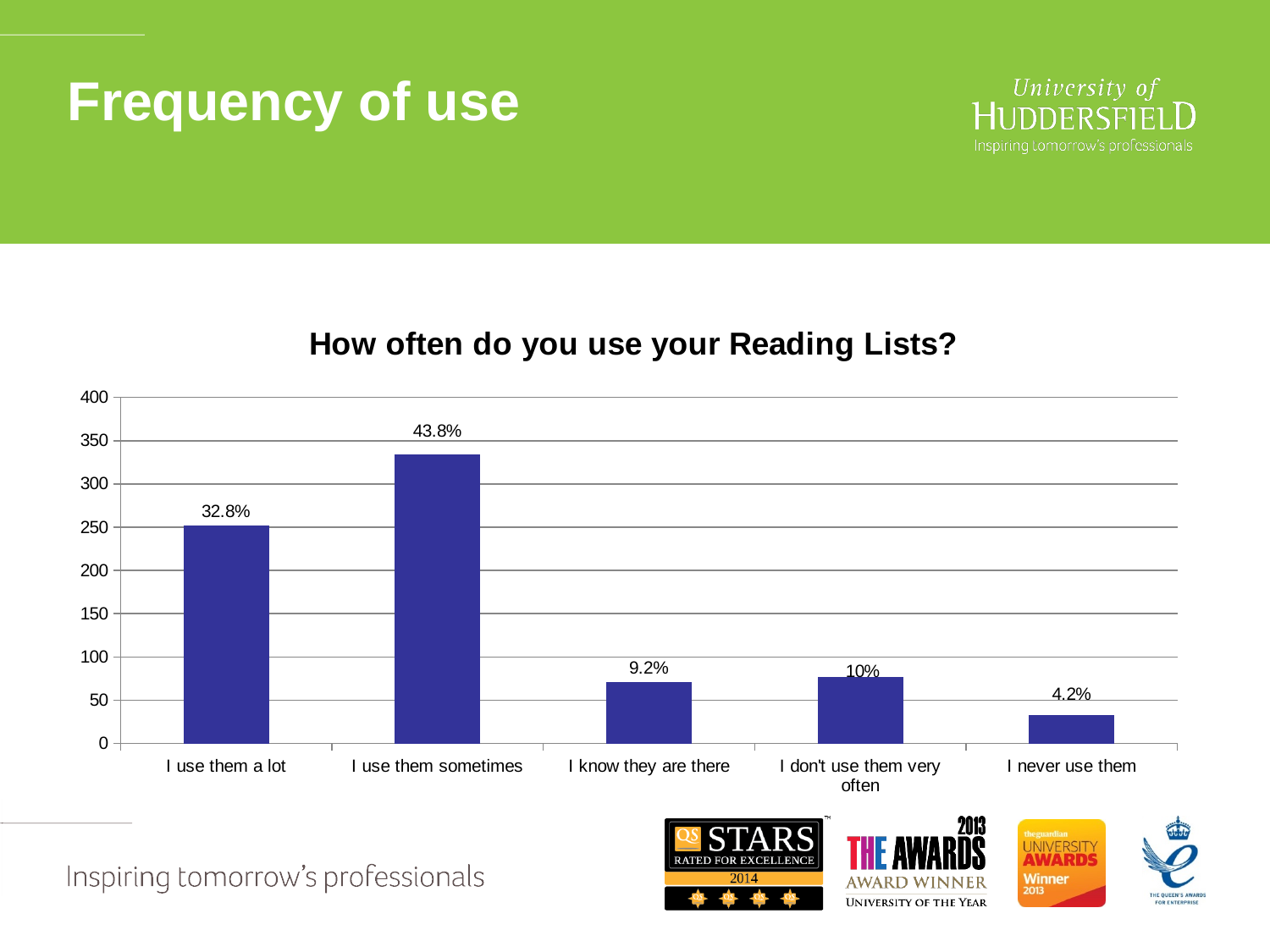
Which has the larger labelled percentage: "I don't use them very often" or "I know they are there"? I don't use them very often What is the difference in percentage points between the labels for "I use them sometimes" and "I use them a lot"? 11% Is the bar for "I use them a lot" greater or less than 200 on the vertical axis? greater What percentage label is shown for "I never use them"? 4.2% How many categories are shown on the x axis? 5 Is the bar for "I never use them" greater or less than 50 on the vertical axis? less What percentage label is shown for "I use them a lot"? 32.8% What percentage label is shown for "I use them sometimes"? 43.8% Which category has the lowest bar? I never use them Which category has the highest bar? I use them sometimes What percentage label is shown for "I know they are there"? 9.2% What type of chart is shown on the slide? Bar chart